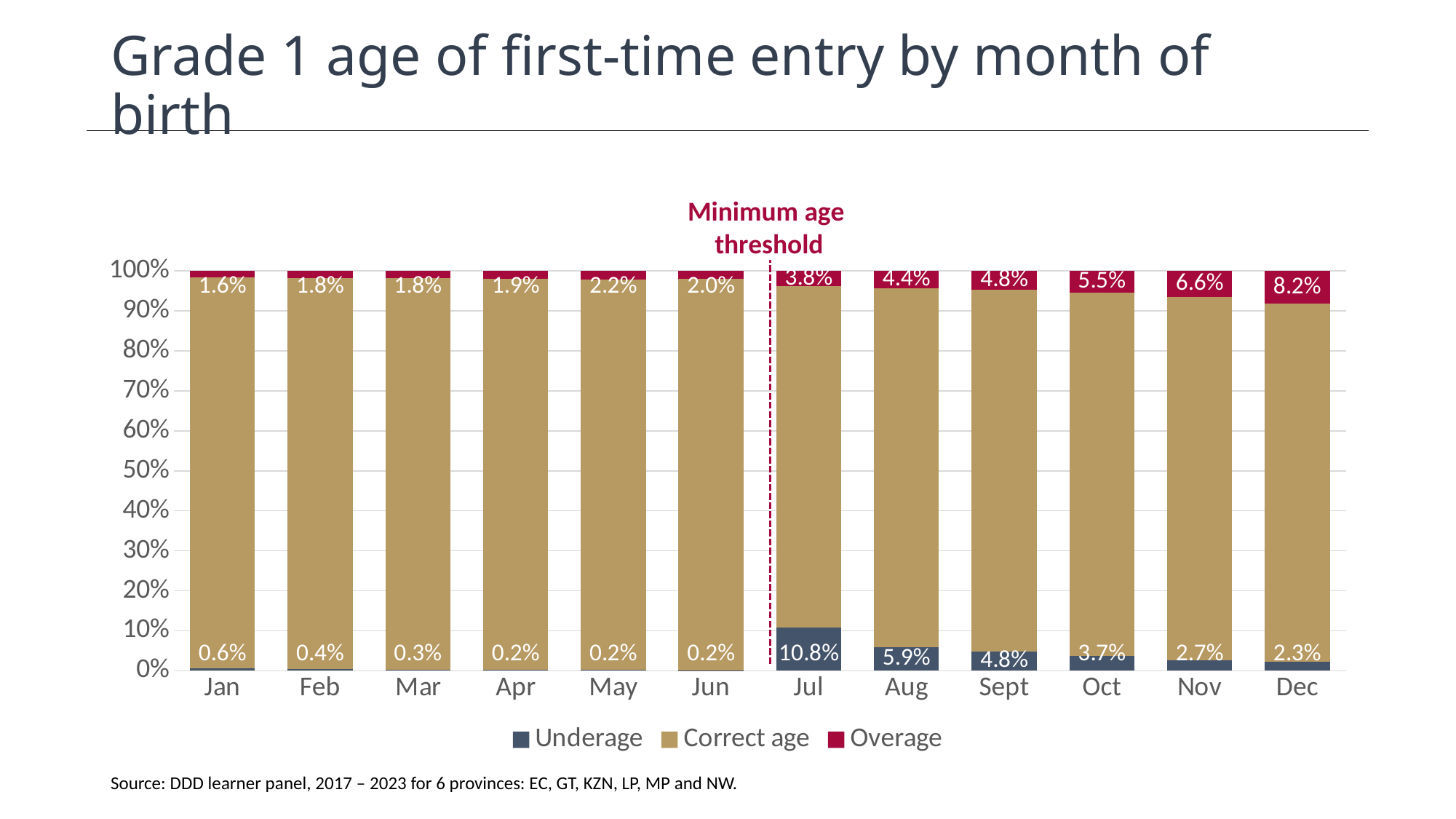
Is the Overage value larger for Nov or for Oct? Nov What is the Overage value for Dec? 8.2% Which month has the highest Overage share? Dec How many series does the legend list? 3 What does the dashed vertical line between Jun and Jul represent, according to its label? Minimum age threshold Which month has the lowest Overage share? Jan Which month has the highest Underage share? Jul What kind of chart is shown on the slide? Stacked bar chart How many months are shown on the x axis? 12 What is the difference between the Overage value for Dec and the Overage value for Jan? 6.6% What is the Underage value for Jul? 10.8% What is the Overage value for Jan? 1.6%